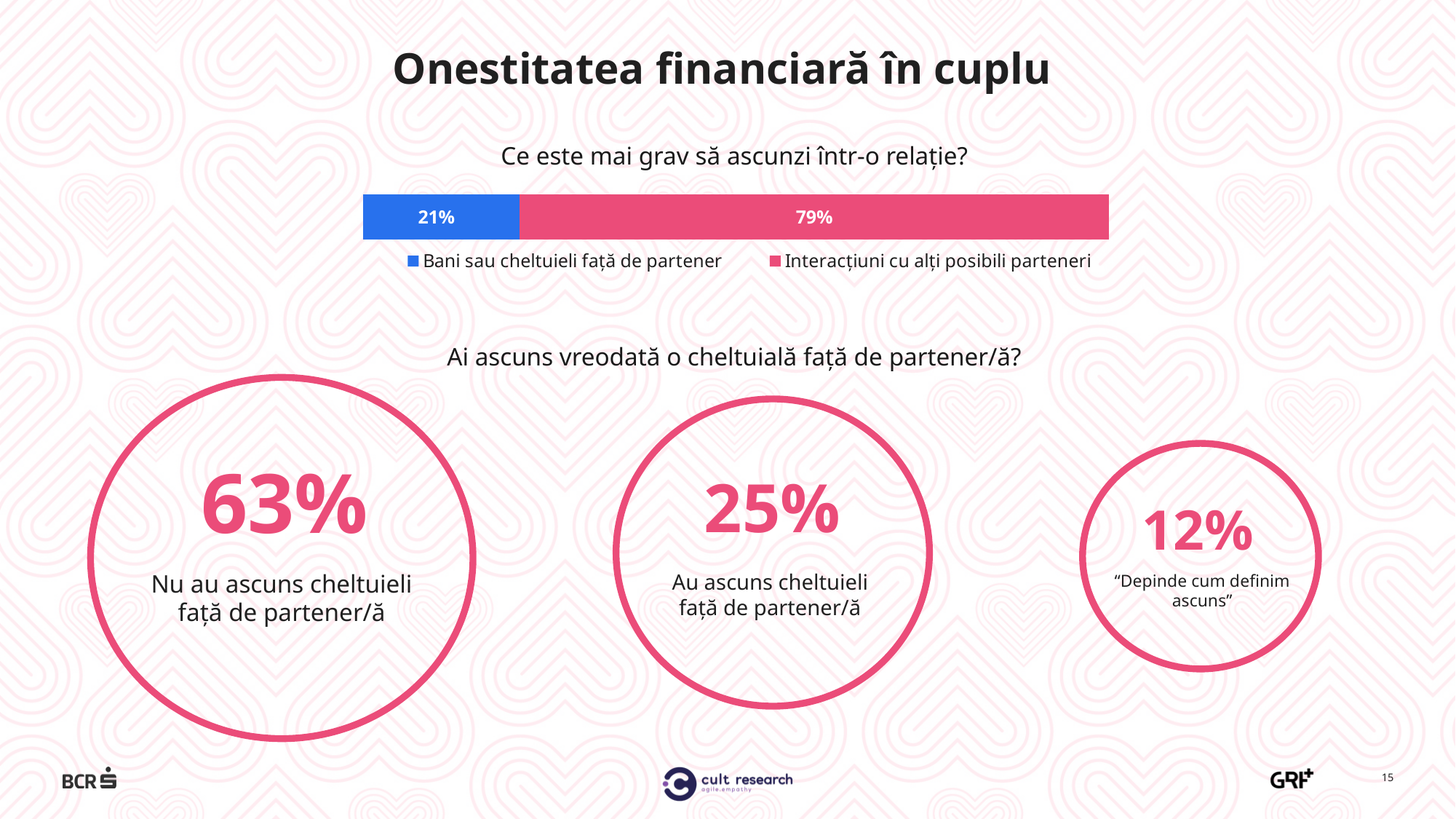
How many circles are shown under 'Ai ascuns vreodată o cheltuială față de partener/ă?'? 3 In the bar chart 'Ce este mai grav să ascunzi într-o relație?', which colour represents 'Bani sau cheltuieli față de partener'? Blue In the bar chart 'Ce este mai grav să ascunzi într-o relație?', what is the difference between the two series' values? 58% What kind of chart is shown under 'Ce este mai grav să ascunzi într-o relație?'? Stacked bar chart How many series does the legend of the bar chart 'Ce este mai grav să ascunzi într-o relație?' list? 2 In the bar chart 'Ce este mai grav să ascunzi într-o relație?', what is the total of the stacked bar? 100% In the bar chart 'Ce este mai grav să ascunzi într-o relație?', what is the value for 'Interacțiuni cu alți posibili parteneri'? 79% In the circles under 'Ai ascuns vreodată o cheltuială față de partener/ă?', what is the value for 'Au ascuns cheltuieli față de partener/ă'? 25% In the bar chart 'Ce este mai grav să ascunzi într-o relație?', which series has the larger value? Interacțiuni cu alți posibili parteneri In the circles under 'Ai ascuns vreodată o cheltuială față de partener/ă?', which category has the highest value? Nu au ascuns cheltuieli față de partener/ă In the bar chart 'Ce este mai grav să ascunzi într-o relație?', which series has the smaller value? Bani sau cheltuieli față de partener In the bar chart 'Ce este mai grav să ascunzi într-o relație?', what is the value for 'Bani sau cheltuieli față de partener'? 21%